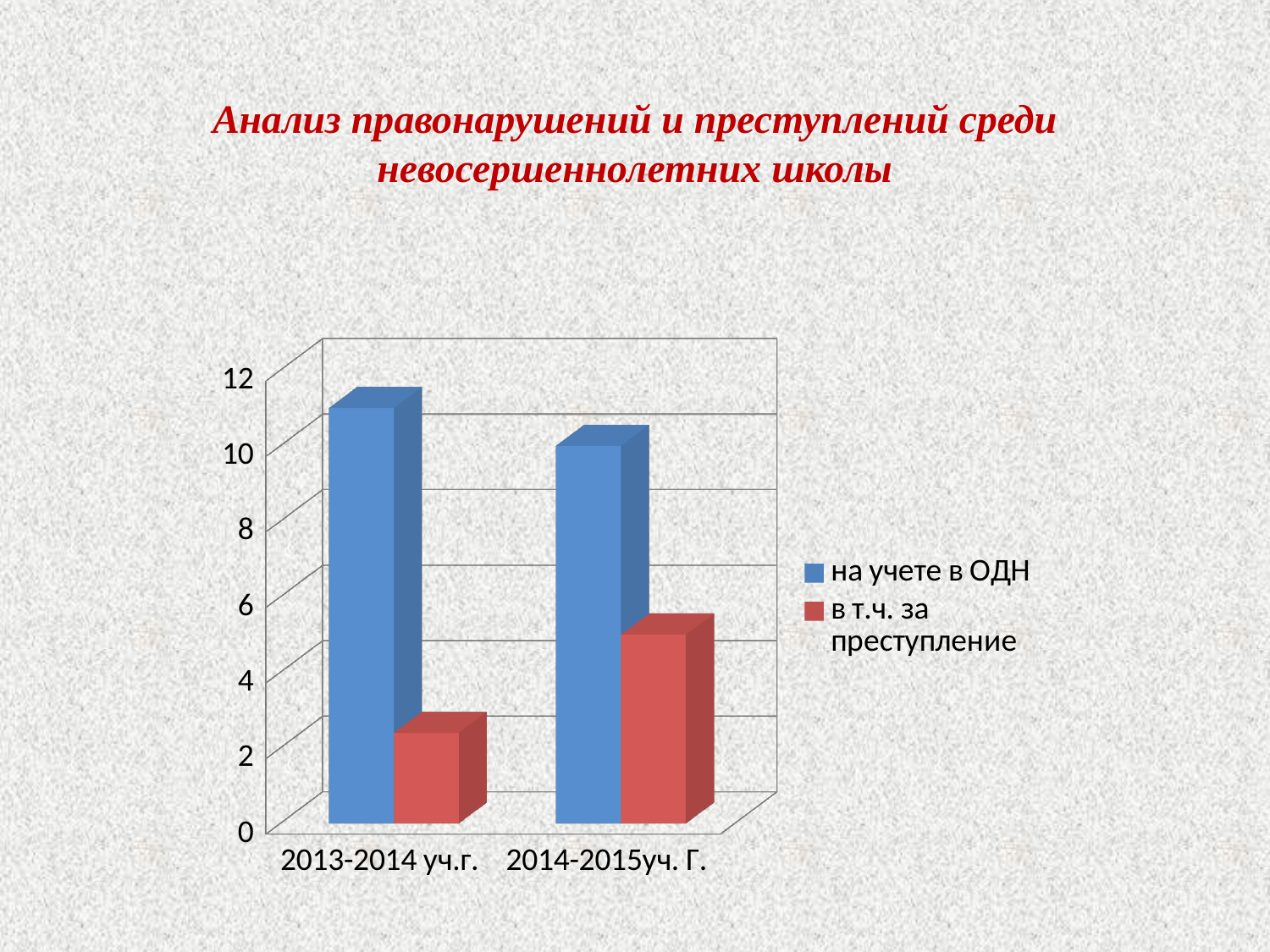
Is the value for 'на учете в ОДН' in 2014-2015уч. Г. greater or less than 8? greater Which series is shown in red? в т.ч. за преступление Which series is shown in blue? на учете в ОДН Is the value for 'в т.ч. за преступление' in 2013-2014 уч.г. greater or less than 4? less Which category has the higher value for 'в т.ч. за преступление', 2013-2014 уч.г. or 2014-2015уч. Г.? 2014-2015уч. Г. Which bar is the lowest on the chart? в т.ч. за преступление, 2013-2014 уч.г. What kind of chart is shown on the slide? bar chart How many series does the legend list? 2 Is the value for 'на учете в ОДН' in 2013-2014 уч.г. greater or less than 8? greater Does the value for 'в т.ч. за преступление' rise or fall from 2013-2014 уч.г. to 2014-2015уч. Г.? rise How many categories are shown on the x axis? 2